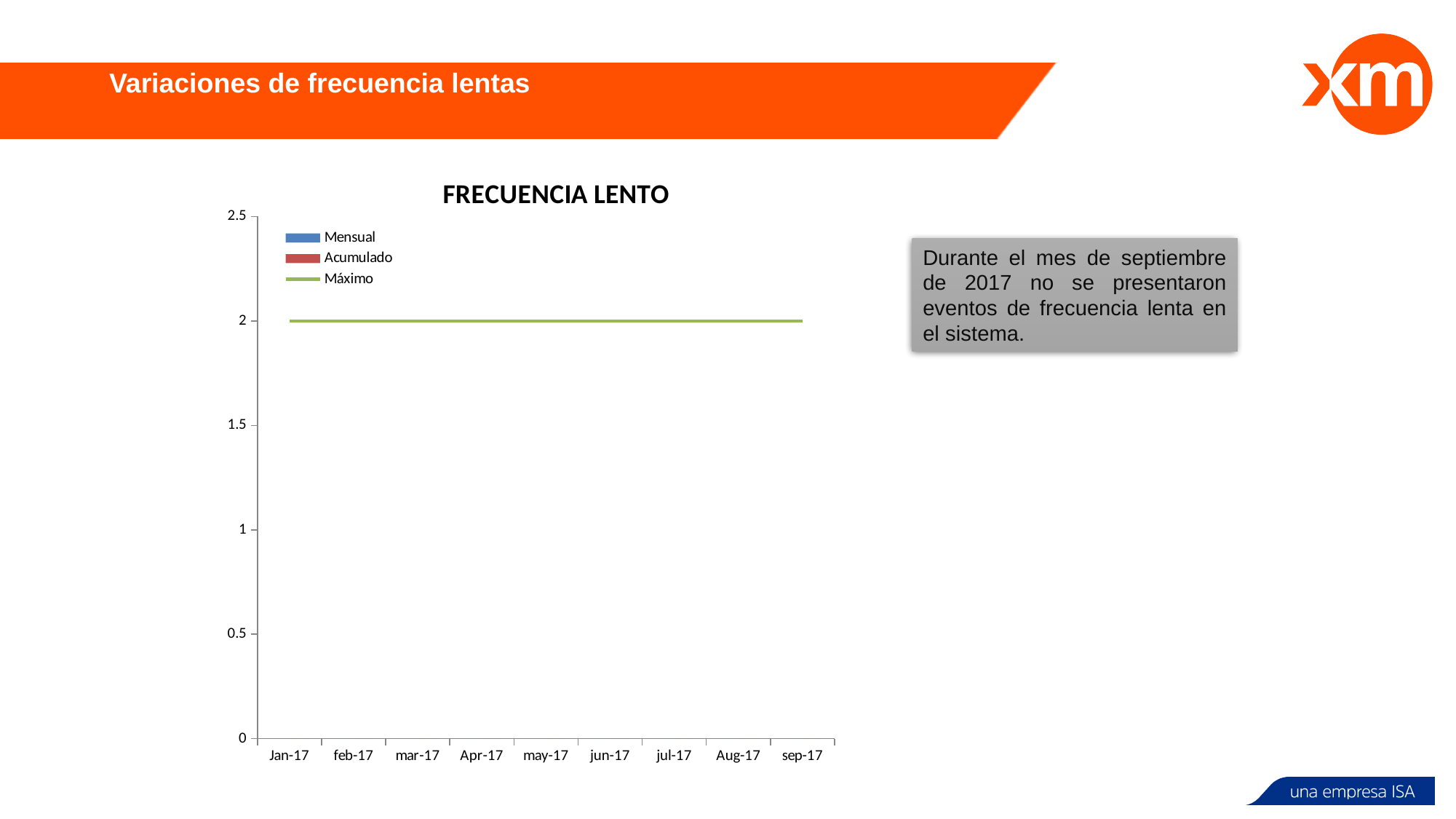
Is the value of the Máximo line in jun-17 greater or less than 2.5? less What is the highest value shown on the y axis of the chart? 2.5 What is the value of the Máximo line in Jan-17? 2 What is the last month shown on the x axis? sep-17 What is the value of the Máximo line in sep-17? 2 Is the value of the Máximo line in mar-17 greater or less than 1.5? greater What is the title of the chart? FRECUENCIA LENTO What is the first month shown on the x axis? Jan-17 Does the Máximo line rise, fall or stay flat from Jan-17 to sep-17? stays flat How many series does the chart legend list? 3 Which series in the legend is drawn as a green line? Máximo How many months are shown on the x axis of the chart? 9